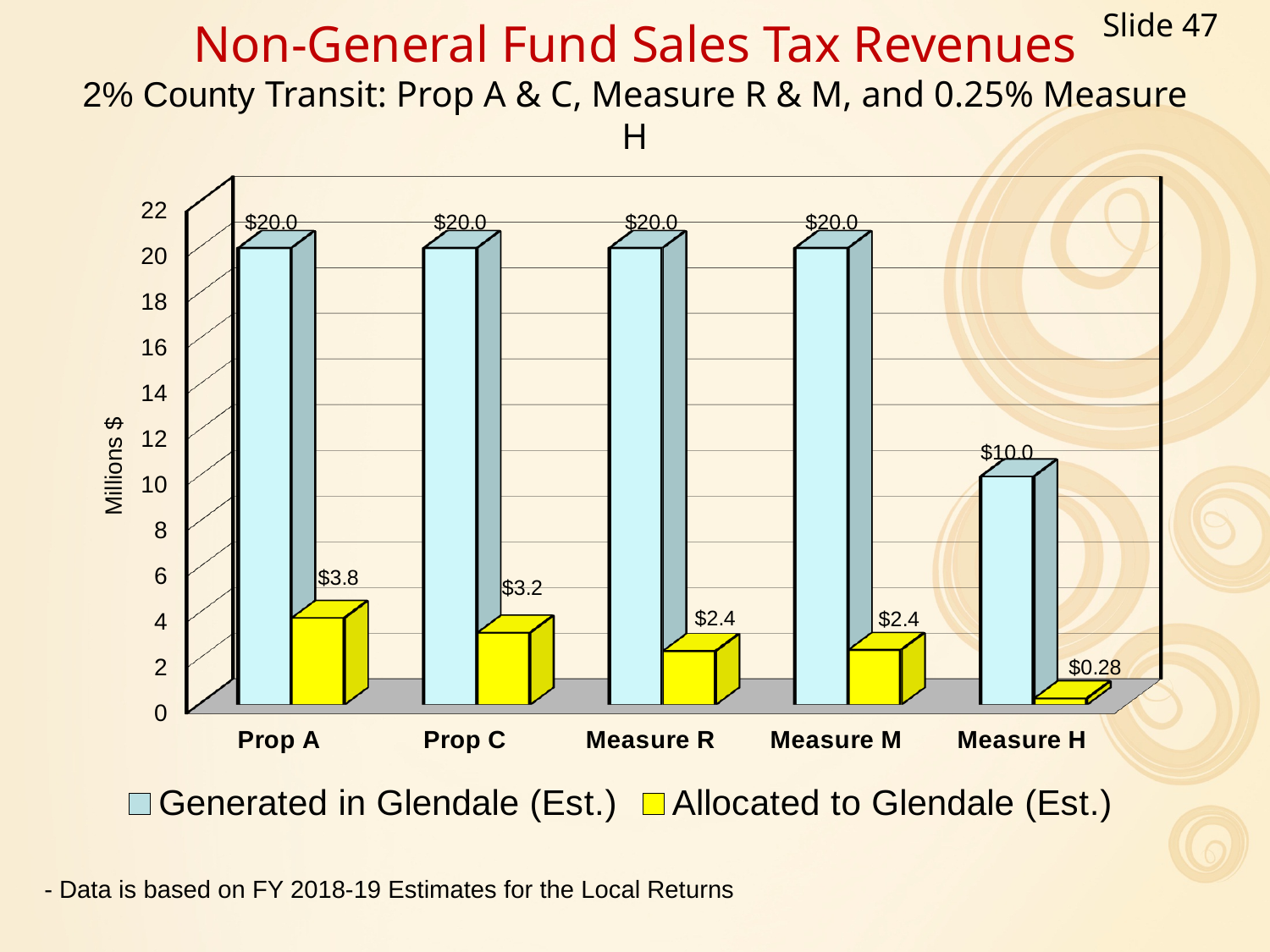
What is the value for Generated in Glendale (Est.) for Measure H? $10.0 What is the value for Generated in Glendale (Est.) for Prop A? $20.0 Which category has the lowest Generated in Glendale (Est.) value? Measure H What is the label of the vertical axis? Millions $ Which is larger, the Allocated to Glendale (Est.) value for Prop C or for Measure R? Prop C What kind of chart is shown on the slide? Bar chart How many series does the legend list? 2 What is the difference between the Generated in Glendale (Est.) and Allocated to Glendale (Est.) values for Prop A? $16.2 How many categories are shown on the x axis? 5 What is the value for Allocated to Glendale (Est.) for Prop C? $3.2 Which category has the highest Allocated to Glendale (Est.) value? Prop A What is the value for Allocated to Glendale (Est.) for Measure H? $0.28